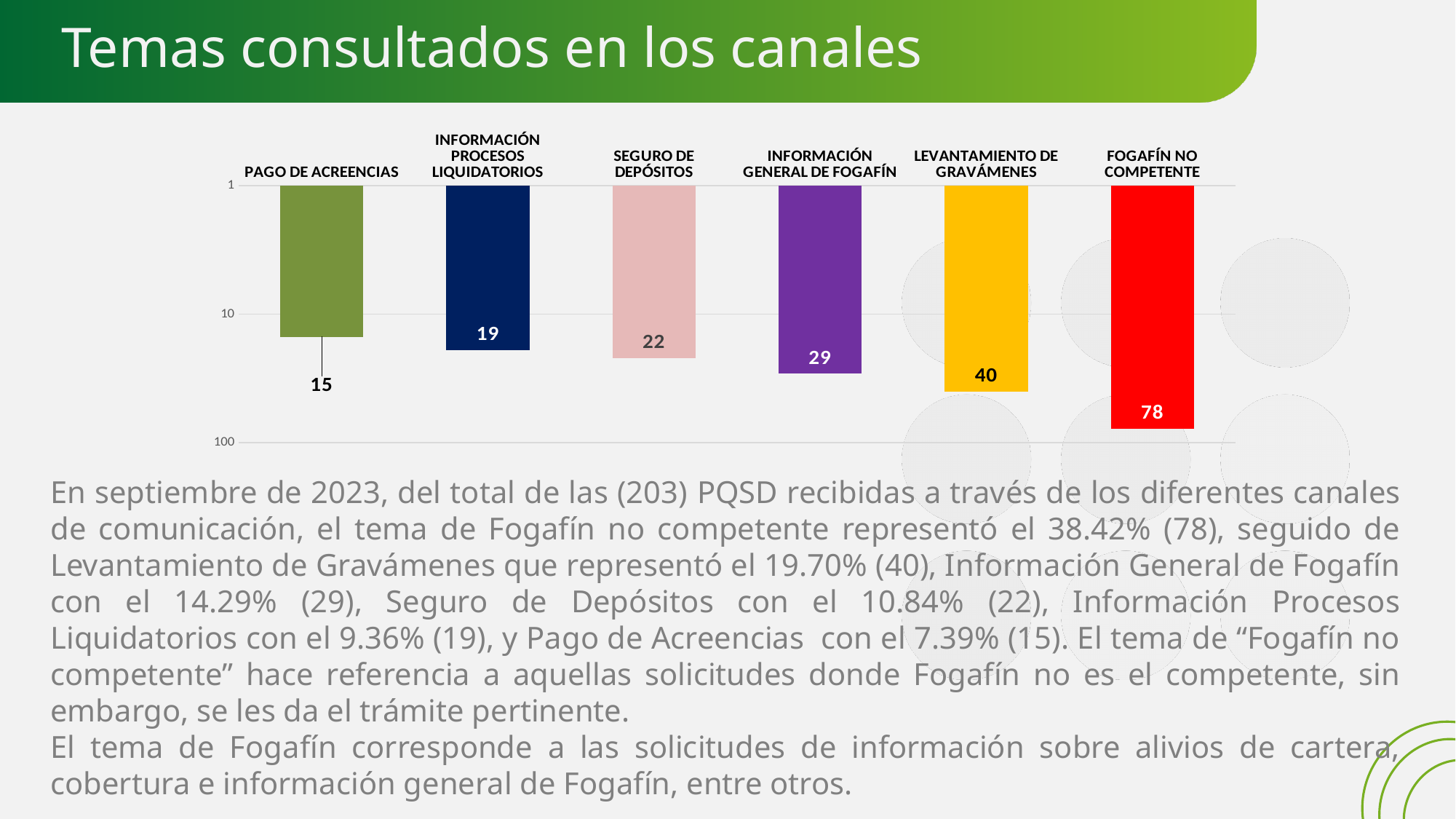
Which category has the lowest value? PAGO DE ACREENCIAS How many categories are shown in the chart? 6 What is the value for SEGURO DE DEPÓSITOS? 22 Which category has the highest value? FOGAFÍN NO COMPETENTE Do the values rise or fall moving from left to right across the categories? rise What is the value for LEVANTAMIENTO DE GRAVÁMENES? 40 What is the value for PAGO DE ACREENCIAS? 15 What kind of chart is shown on the slide? bar chart Which is larger, the value for INFORMACIÓN PROCESOS LIQUIDATORIOS or the value for SEGURO DE DEPÓSITOS? SEGURO DE DEPÓSITOS What is the value for INFORMACIÓN GENERAL DE FOGAFÍN? 29 What colour is the bar for FOGAFÍN NO COMPETENTE? red What is the difference between the values for FOGAFÍN NO COMPETENTE and LEVANTAMIENTO DE GRAVÁMENES? 38